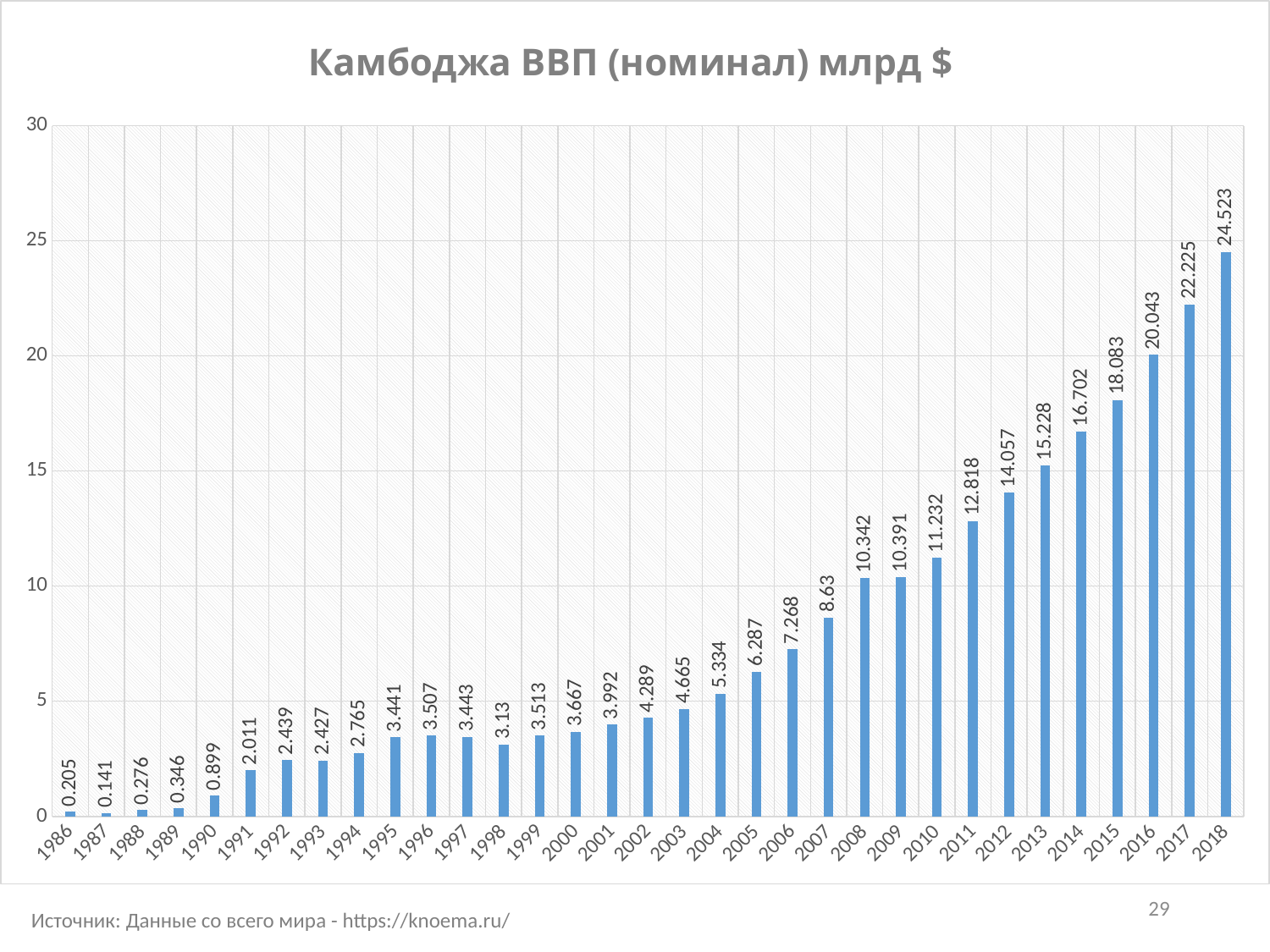
How many years are shown on the x axis? 33 Which is larger, the value for 1996 or the value for 1998? 1996 What kind of chart is this? bar chart Do the values generally rise or fall from 1986 to 2018? rise What is the value for 2007? 8.63 Which year has the highest value? 2018 Is the value for 2015 greater or less than 15? greater What is the title of the chart? Камбоджа ВВП (номинал) млрд $ What is the value for 1990? 0.899 What is the value for 2018? 24.523 Which year has the lowest value? 1987 What is the difference between the values for 2018 and 2017? 2.298